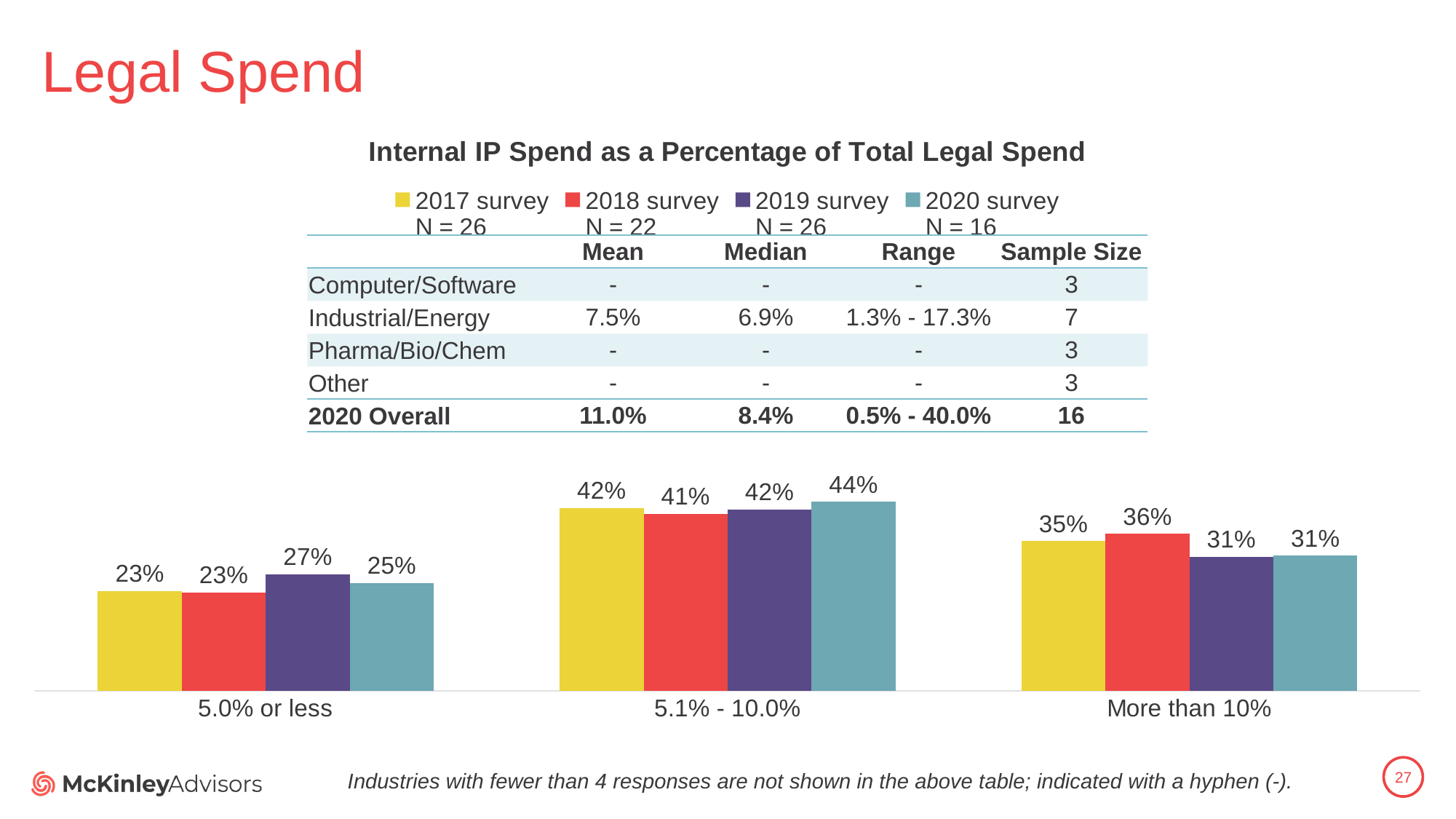
What kind of chart is shown on the slide? Bar chart What is the value for the 2018 survey in the "More than 10%" category? 36% What is the difference between the 2020 survey and the 2017 survey values in the "5.1% - 10.0%" category? 2% How many categories are shown on the x axis of the chart? 3 What is the value for the 2020 survey in the "5.1% - 10.0%" category? 44% What is the value for the 2019 survey in the "5.0% or less" category? 27% What is the sample size (N) shown in the legend for the 2020 survey? N = 16 In the "5.0% or less" category, which is larger: the 2019 survey value or the 2020 survey value? 2019 survey Which category has the highest value for the 2017 survey? 5.1% - 10.0% Which category has the lowest value for the 2020 survey? 5.0% or less How many series does the chart legend list? 4 What is the difference between the 2018 survey and the 2019 survey values in the "More than 10%" category? 5%